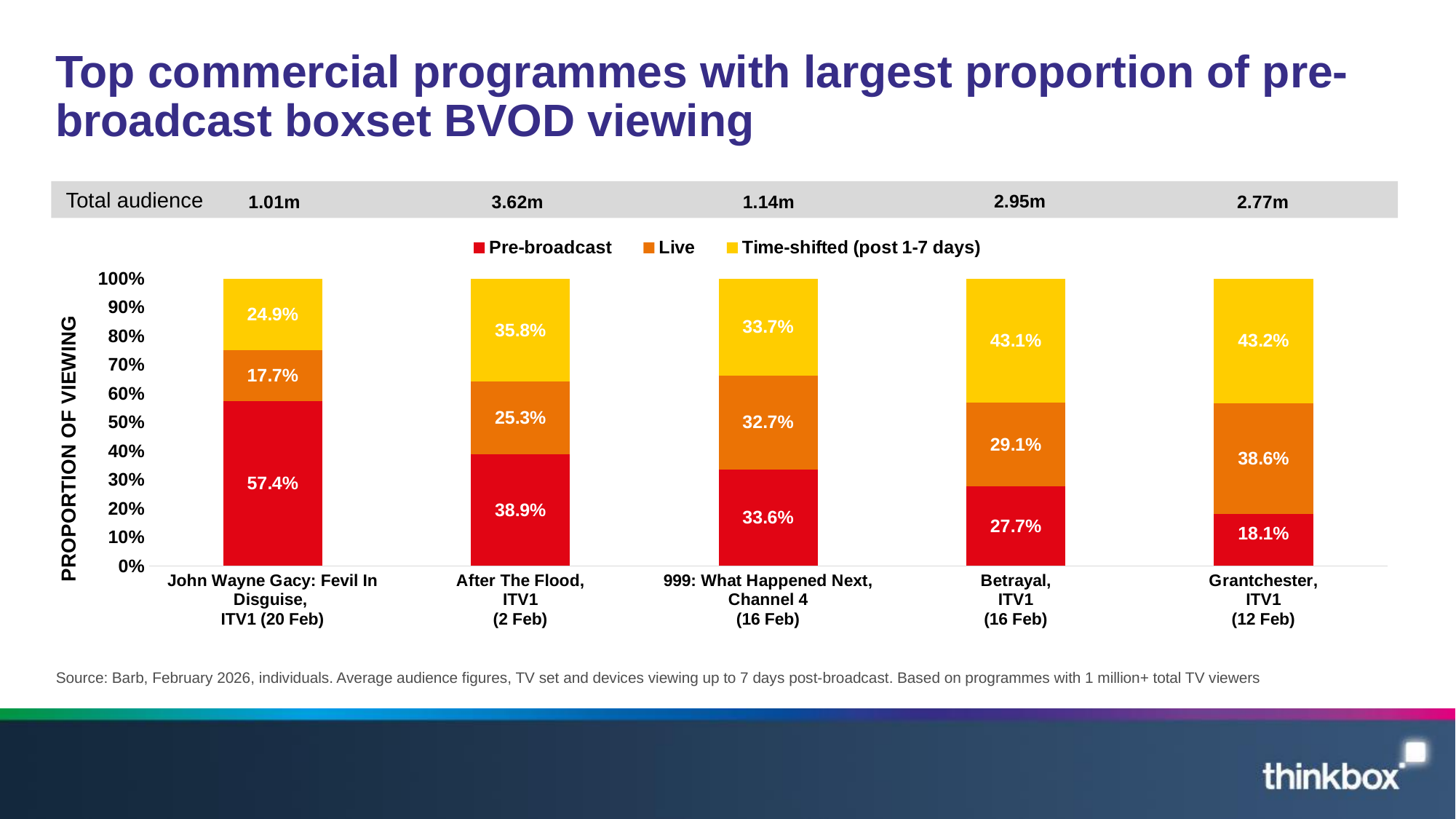
Which programme has the highest Pre-broadcast share? John Wayne Gacy: Fevil In Disguise What is the Pre-broadcast share for John Wayne Gacy: Fevil In Disguise? 57.4% How many series does the legend list? 3 What is the Live share for Grantchester? 38.6% Which programme has the lowest Pre-broadcast share? Grantchester Which is larger: the Live share for Betrayal or the Live share for 999: What Happened Next? 999: What Happened Next How many programmes are shown on the chart? 5 What colour represents the Live series in the chart? Orange What kind of chart is shown? Stacked bar chart What is the difference between the Pre-broadcast share for After The Flood and for 999: What Happened Next? 5.3% Which programme has the lowest Time-shifted (post 1-7 days) share? John Wayne Gacy: Fevil In Disguise What is the Time-shifted (post 1-7 days) share for Betrayal? 43.1%